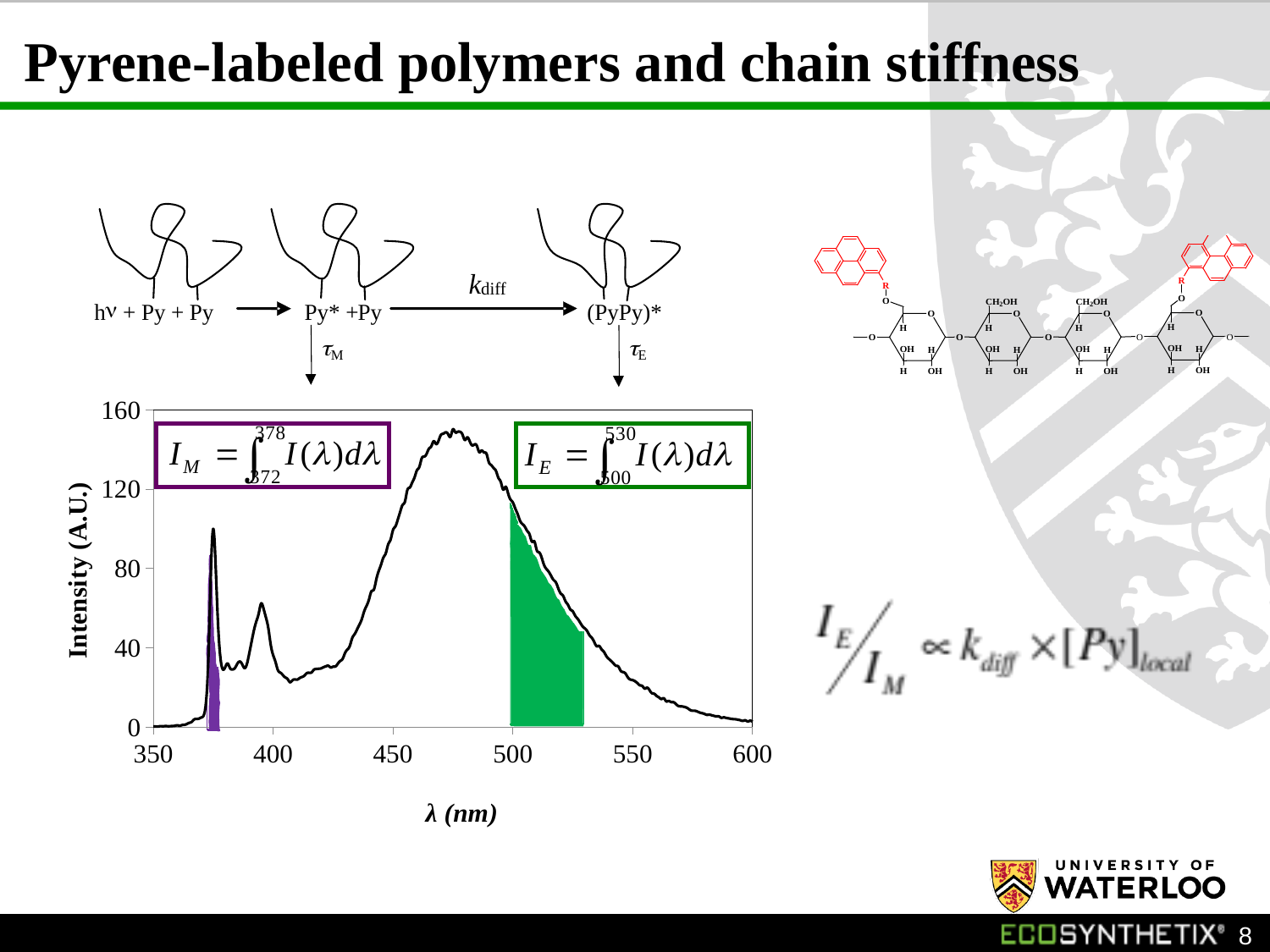
Which is higher: the intensity at the broad peak near 475 nm or the sharp peak near 375 nm? the broad peak near 475 nm What kind of chart is shown on the slide? line chart Is the intensity at the peak near 395 nm greater or less than 40? greater What is the label of the x axis of the chart? λ (nm) What is the label of the y axis of the chart? Intensity (A.U.) Does the intensity rise or fall as the wavelength increases from 500 nm to 600 nm? fall Is the intensity at 550 nm greater or less than 40? less Does the intensity rise or fall as the wavelength increases from 420 nm to 470 nm? rise How many tick labels are shown on the x axis of the chart? 6 Is the intensity at 600 nm greater or less than 40? less